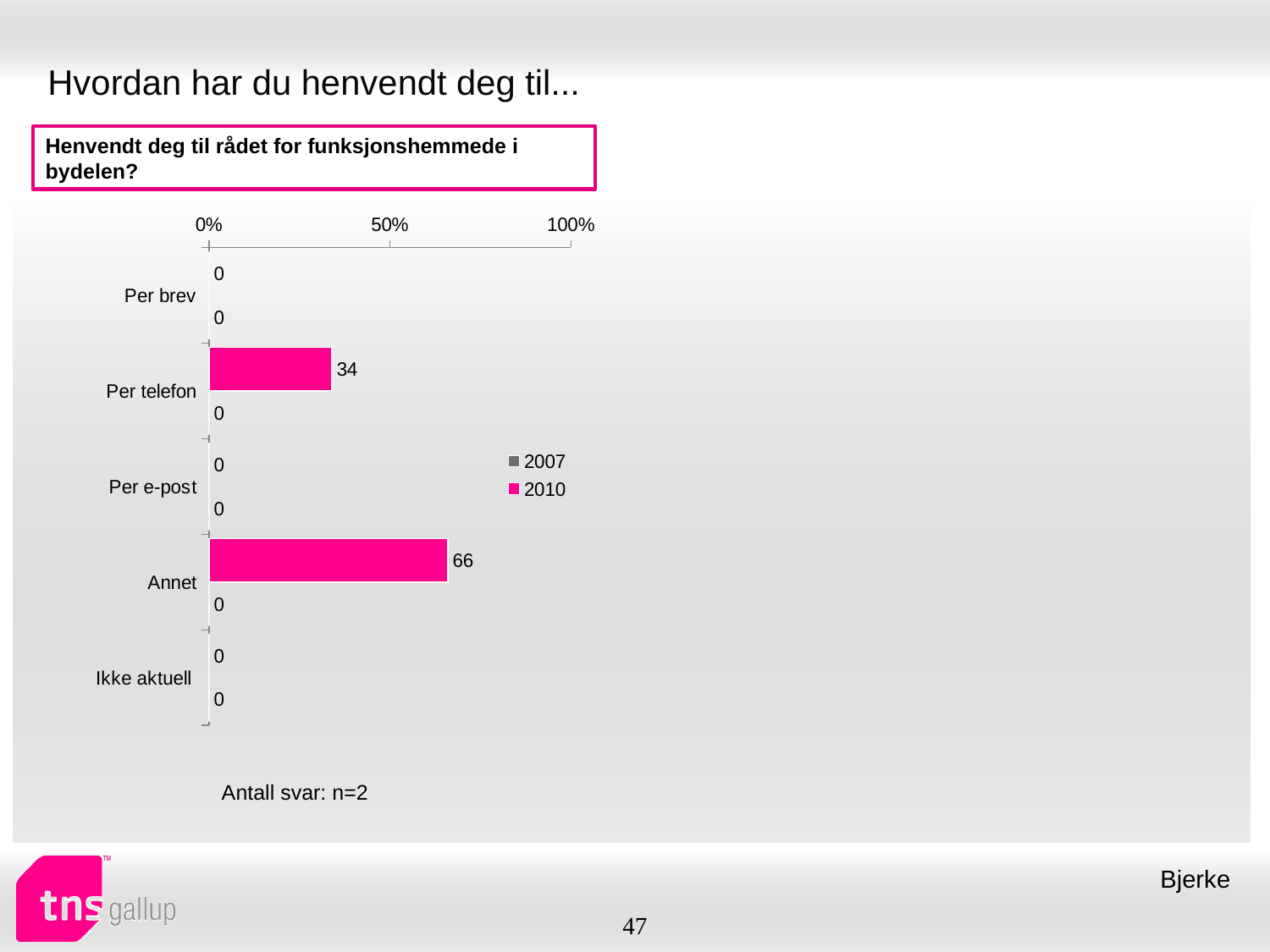
What type of chart is shown on the slide? bar chart What is the 2010 value for Per e-post? 0 Which is larger for 2010: Per telefon or Annet? Annet How many categories are shown on the chart? 5 What is the number of responses (Antall svar) stated below the chart? n=2 What is the 2010 value for Annet? 66 Which category has the highest 2010 value? Annet What is the 2007 value for Per telefon? 0 What is the 2010 value for Per telefon? 34 How many series does the legend list? 2 Is the 2010 value for Annet greater or less than 50%? greater What is the difference between the 2010 values for Annet and Per telefon? 32